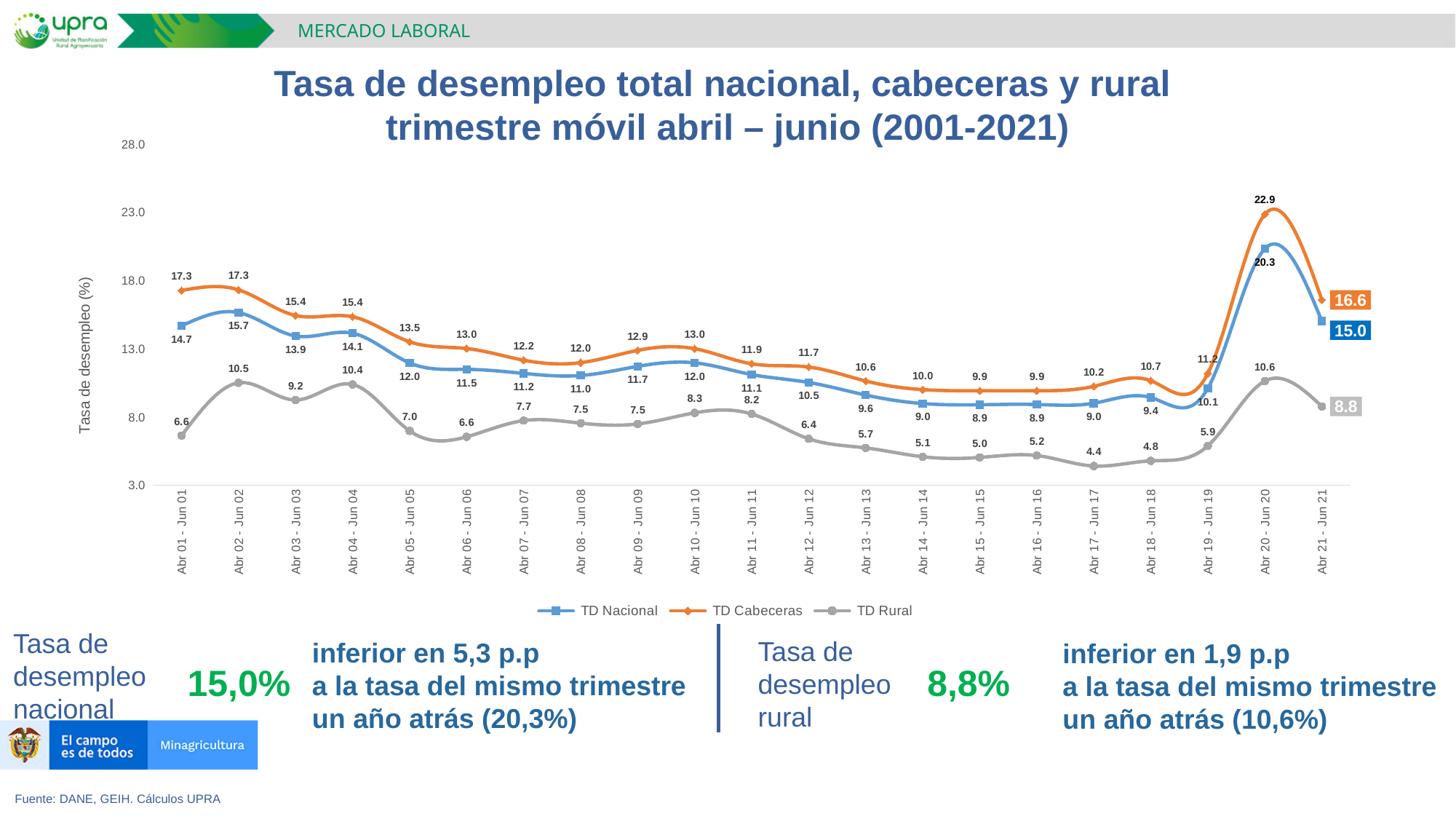
Which is larger for Abr 10 - Jun 10: TD Cabeceras or TD Rural? TD Cabeceras How many periods are plotted on the x axis? 21 What is the value of TD Cabeceras for Abr 20 - Jun 20? 22.9 How many series does the legend list? 3 What kind of chart is shown on the slide? Line chart In which period does TD Nacional reach its highest value? Abr 20 - Jun 20 What is the difference between the TD Rural values for Abr 20 - Jun 20 and Abr 21 - Jun 21? 1.8 What is the value of TD Nacional for Abr 01 - Jun 01? 14.7 In which period does TD Rural reach its lowest value? Abr 17 - Jun 17 Does TD Cabeceras generally rise or fall from Abr 01 - Jun 01 to Abr 16 - Jun 16? Fall What is the difference between the TD Nacional values for Abr 20 - Jun 20 and Abr 21 - Jun 21? 5.3 What is the value of TD Rural for Abr 21 - Jun 21? 8.8